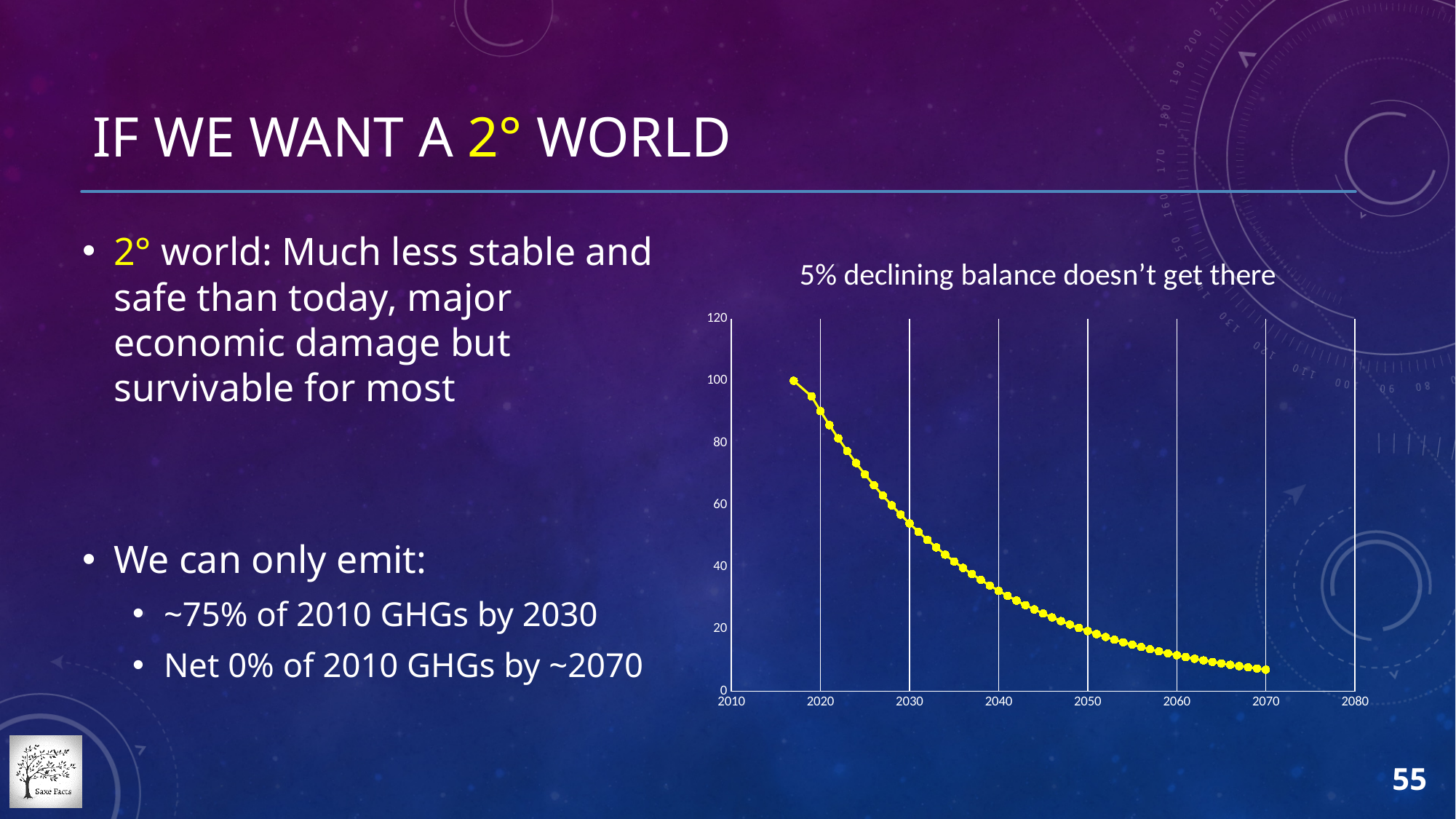
Is the plotted value at 2070 greater or less than 20? less What kind of chart is shown on the slide? line chart Is the plotted value at 2020 greater or less than 80? greater Is the plotted value at 2030 greater or less than 40? greater Do the plotted values rise or fall as the years increase along the x axis? fall What is the highest value shown on the y axis of the chart? 120 Which is larger, the plotted value at 2030 or the plotted value at 2050? 2030 What is the title of the chart on the slide? 5% declining balance doesn't get there Which year on the x axis has the lowest plotted value? 2070